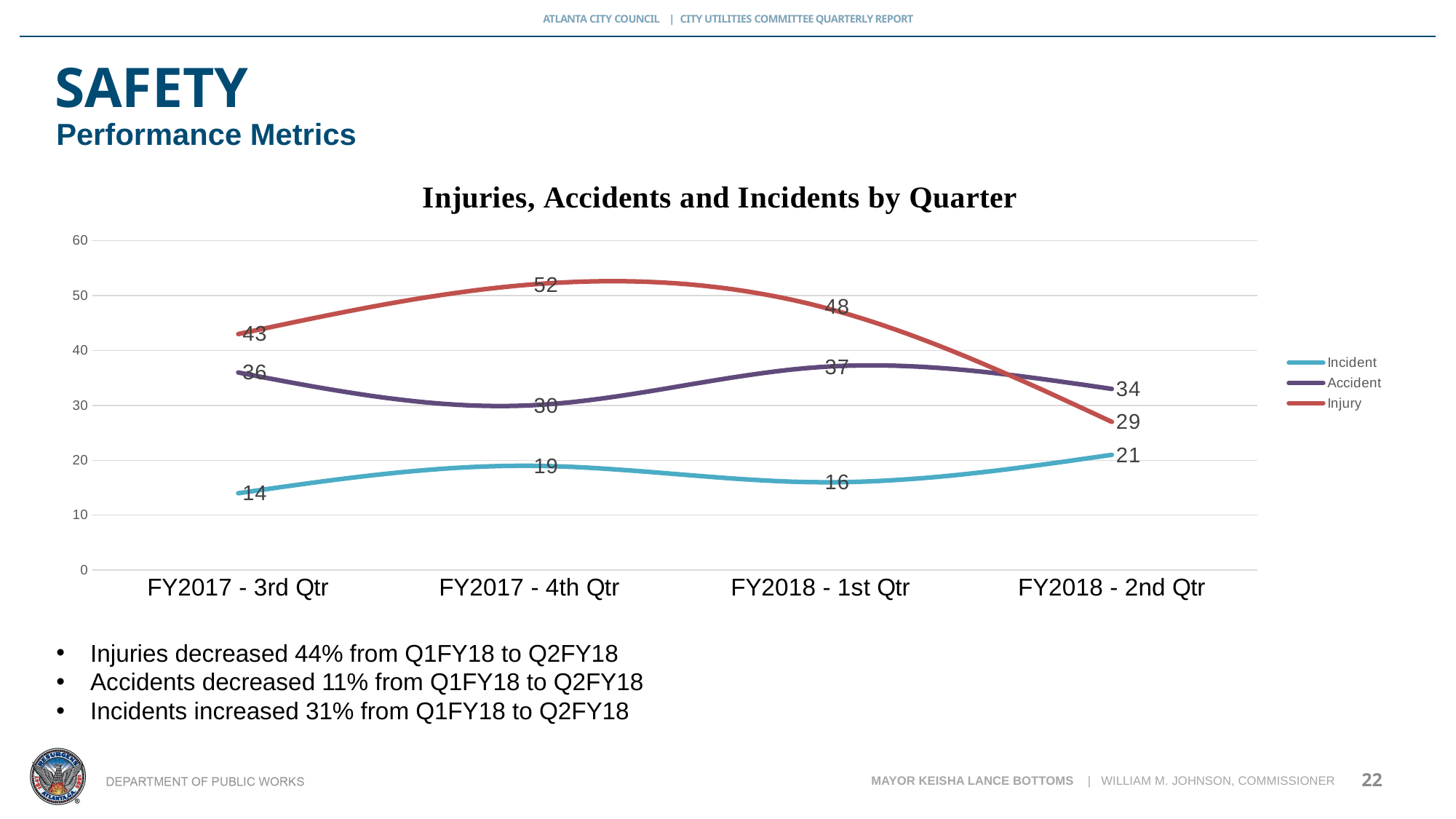
What is the Incident value for FY2017 - 3rd Qtr? 14 How many series does the legend list? 3 In which quarter is the Injury series highest? FY2017 - 4th Qtr Is the Injury value for FY2018 - 2nd Qtr greater or less than 30? less What is the Accident value for FY2018 - 2nd Qtr? 34 Does the Injury series rise or fall from FY2017 - 4th Qtr to FY2018 - 2nd Qtr? fall What is the difference between the Injury value and the Accident value in FY2018 - 1st Qtr? 11 Which is larger in FY2018 - 2nd Qtr, the Accident value or the Injury value? Accident How many quarters are shown on the x axis? 4 In which quarter is the Accident series lowest? FY2017 - 4th Qtr What kind of chart is shown? line chart What is the Injury value for FY2017 - 4th Qtr? 52